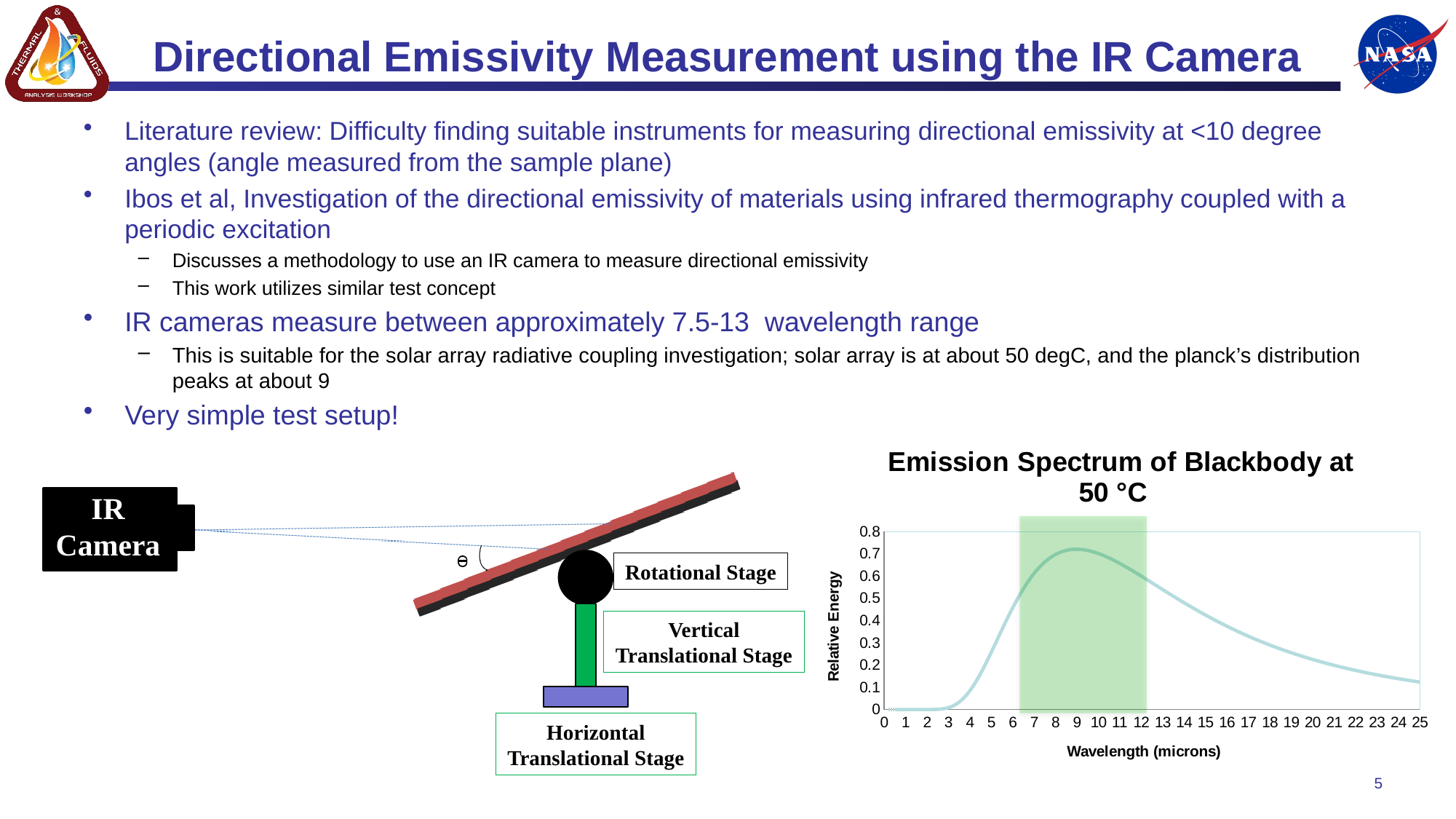
Is the relative energy at a wavelength of 20 microns greater or less than 0.3? less Is the relative energy at a wavelength of 3 microns greater or less than 0.1? less What is the label of the x axis of the chart? Wavelength (microns) Which is larger, the relative energy at 9 microns or at 20 microns? 9 microns What is the title of the chart on the slide? Emission Spectrum of Blackbody at 50 °C What is the highest value shown on the y axis of the chart? 0.8 Is the relative energy at a wavelength of 25 microns greater or less than 0.2? less Does the relative energy rise or fall as wavelength increases from 12 to 25 microns? fall Does the relative energy rise or fall as wavelength increases from 3 to 8 microns? rise What kind of chart is the Emission Spectrum of Blackbody at 50 °C? Line chart